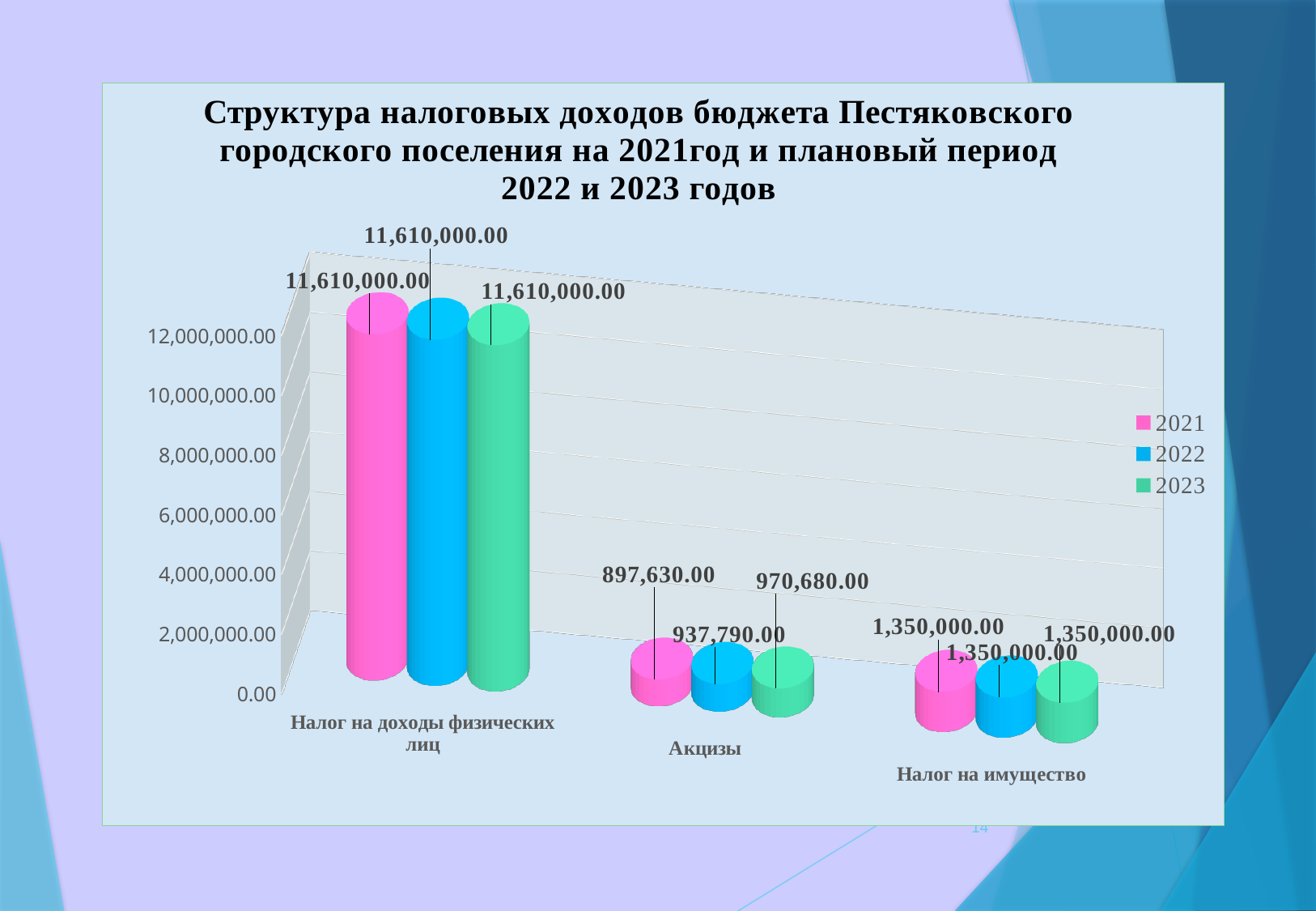
What is the value for Налог на доходы физических лиц in 2023? 11,610,000.00 What is the value for Налог на имущество in 2022? 1,350,000.00 What kind of chart is shown on the slide? Bar chart What is the value for Акцизы in 2023? 970,680.00 Which category has the lowest values in the chart? Акцизы What is the value for Акцизы in 2021? 897,630.00 Which is larger: the 2022 value for Акцизы or the 2022 value for Налог на имущество? Налог на имущество How many categories are shown on the x axis? 3 How many series does the legend list? 3 Which category has the highest values in the chart? Налог на доходы физических лиц What is the difference between the 2023 and 2021 values for Акцизы? 73,050.00 Do the values for Акцизы rise or fall from 2021 to 2023? Rise